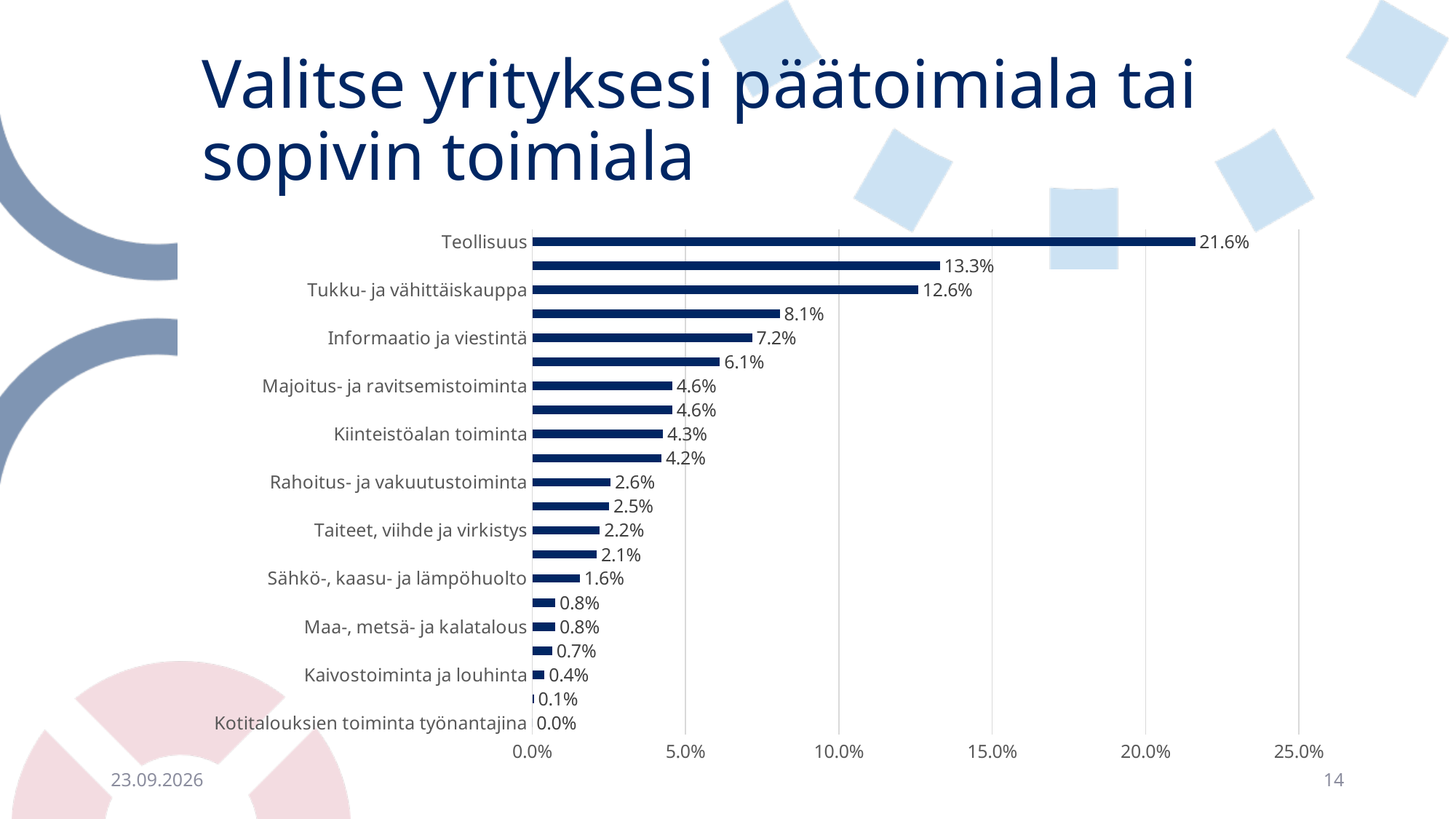
What is the value for Kiinteistöalan toiminta? 4.3% Which is larger, the value for Majoitus- ja ravitsemistoiminta or the value for Rahoitus- ja vakuutustoiminta? Majoitus- ja ravitsemistoiminta Which category has the highest value? Teollisuus What is the value for Tukku- ja vähittäiskauppa? 12.6% Is the value for Teollisuus greater or less than 20.0%? greater How many bars are plotted in the chart? 21 What is the value for Kaivostoiminta ja louhinta? 0.4% What is the value for Teollisuus? 21.6% Which labelled category has the lowest value? Kotitalouksien toiminta työnantajina What is the difference between the values for Teollisuus and Tukku- ja vähittäiskauppa? 9.0 percentage points What kind of chart is shown on the slide? Bar chart What is the value for Informaatio ja viestintä? 7.2%